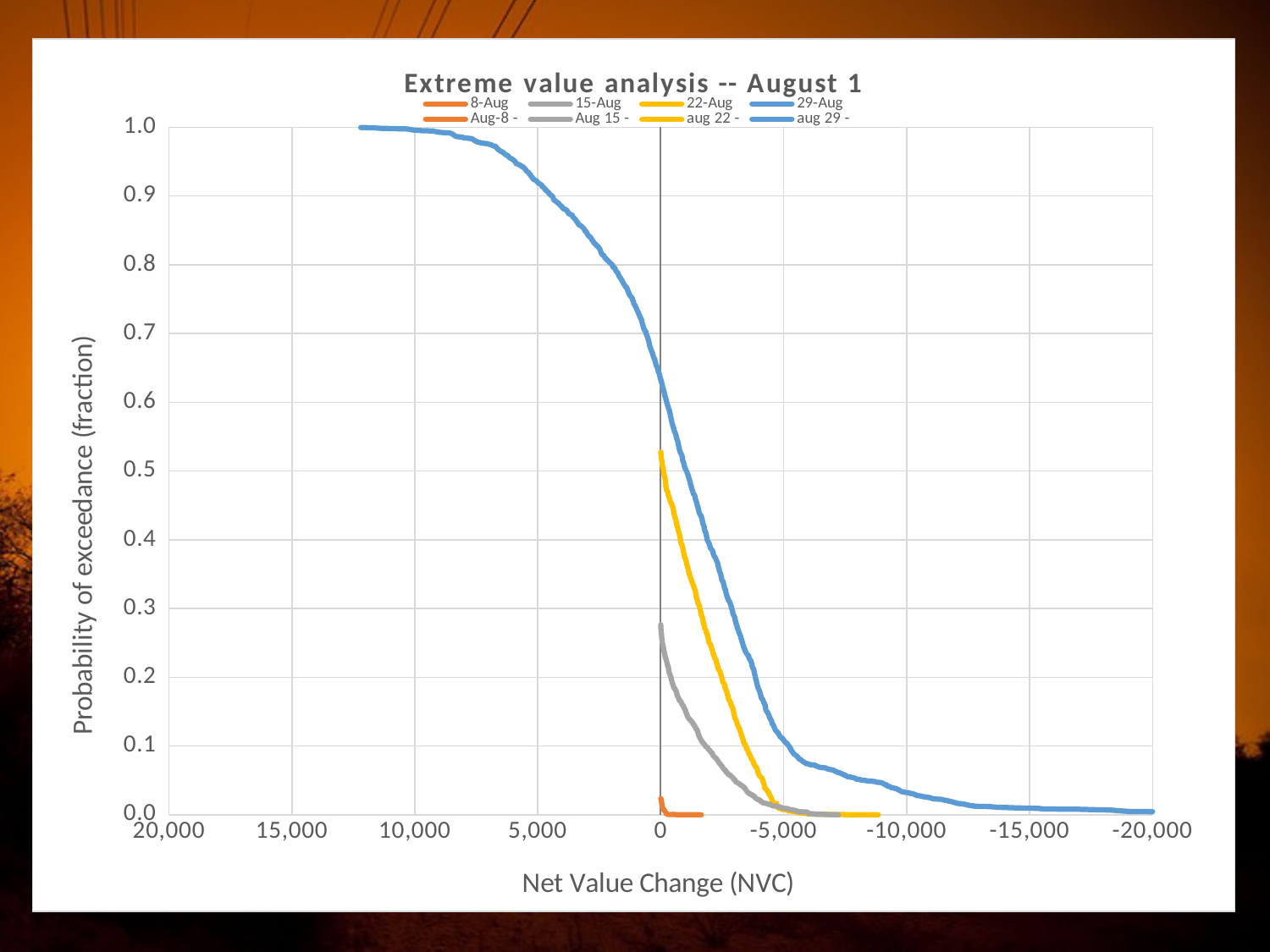
What is the title of the chart? Extreme value analysis -- August 1 Which series has the lowest probability of exceedance at a Net Value Change of 0? Aug-8 - Moving from left to right along the x axis, does the 29-Aug series rise or fall? fall At a Net Value Change of 0, which series has the larger probability of exceedance, 29-Aug or 15-Aug? 29-Aug Is the probability of exceedance for the 29-Aug series at a Net Value Change of 0 greater or less than 0.5? greater What kind of chart is shown on the slide? line chart Is the probability of exceedance for the 15-Aug series at a Net Value Change of 0 greater or less than 0.2? greater How many series does the legend list? 8 At a Net Value Change of -5,000, which series has the larger probability of exceedance, 29-Aug or 22-Aug? 29-Aug What is the label of the x axis? Net Value Change (NVC)